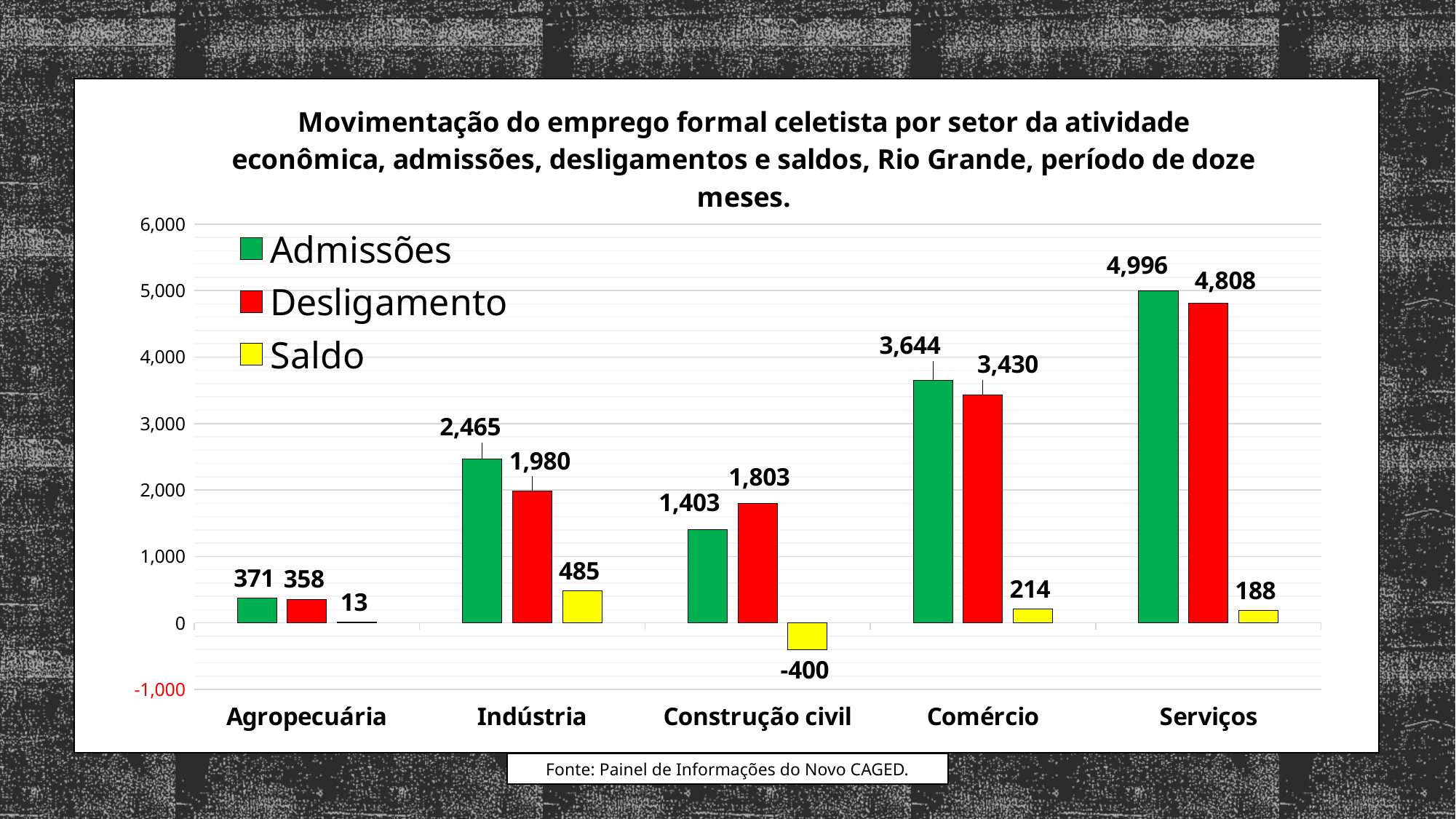
Which sector has the highest Admissões value? Serviços What is the Desligamento value for Indústria? 1,980 What is the Saldo value for Construção civil? -400 What is the Admissões value for Serviços? 4,996 What kind of chart is shown on the slide? Bar chart Which sector has the lowest Desligamento value? Agropecuária How many sectors are shown on the x axis? 5 Which is larger for Construção civil, Admissões or Desligamento? Desligamento What is the difference between Admissões and Desligamento for Comércio? 214 What colour represents the Saldo series? Yellow Is the Admissões value for Indústria greater or less than 2,000? greater How many series does the legend list? 3